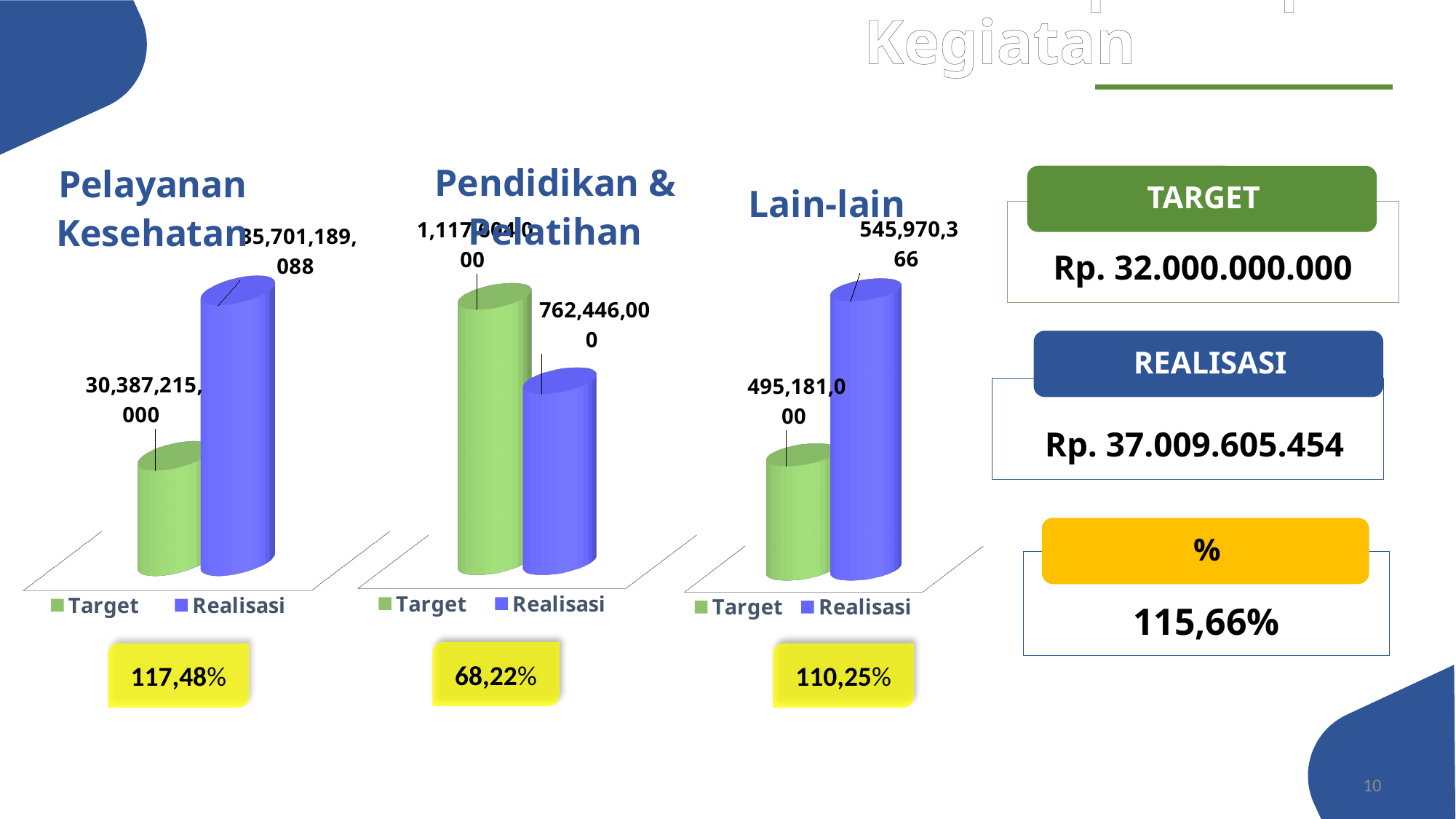
What are the two legend entries in the Pendidikan & Pelatihan chart? Target and Realisasi In the Pelayanan Kesehatan chart, which bar is taller, Target or Realisasi? Realisasi How many series does the legend of the Pelayanan Kesehatan chart list? 2 In the Lain-lain chart, what is the difference between the Realisasi and Target values? 50,789,366 In the Pendidikan & Pelatihan chart, which bar is taller, Target or Realisasi? Target In the Lain-lain chart, which bar is taller, Target or Realisasi? Realisasi How many charts are shown on the slide? 3 What kind of chart is the Lain-lain chart? Bar chart In the Pelayanan Kesehatan chart, what is the value of the Target bar? 30,387,215,000 In the Lain-lain chart, what is the value of the Target bar? 495,181,000 In the Lain-lain chart, what is the value of the Realisasi bar? 545,970,366 In the Pendidikan & Pelatihan chart, what is the value of the Realisasi bar? 762,446,000